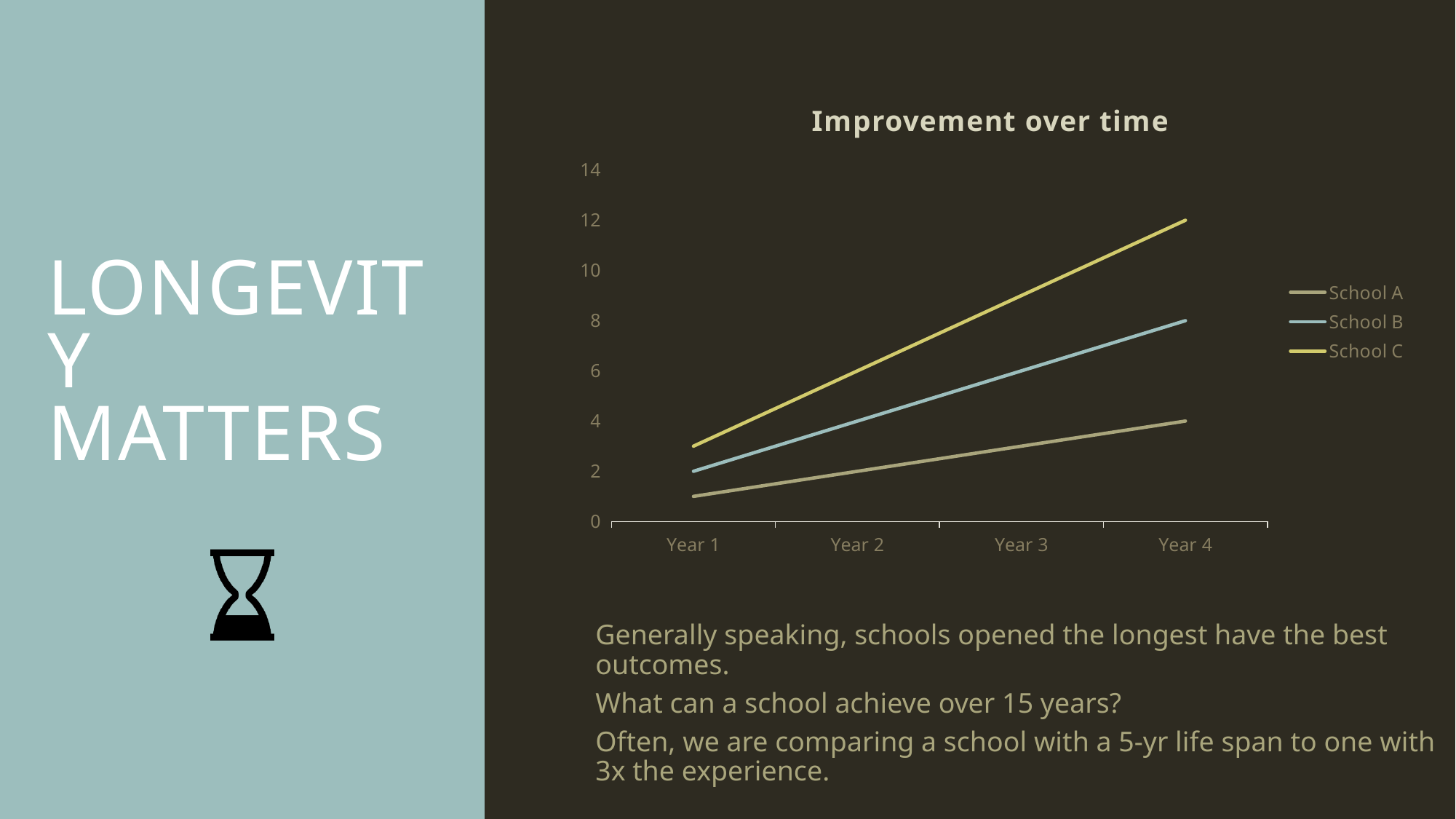
What kind of chart is shown on the slide? line chart Which school has the lowest value in Year 4? School A In Year 2, which is larger, the value for School B or the value for School A? School B Which series is drawn in the yellow line? School C Is the value for School C in Year 4 greater or less than 10? greater Which school has the highest value in Year 4? School C Is the value for School A in Year 1 greater or less than 2? less Is the value for School B in Year 4 greater or less than 6? greater How many points are on the x axis of the chart? 4 Does the value for School C rise or fall from Year 1 to Year 4? rise How many series does the legend list? 3 What is the title of the chart? Improvement over time